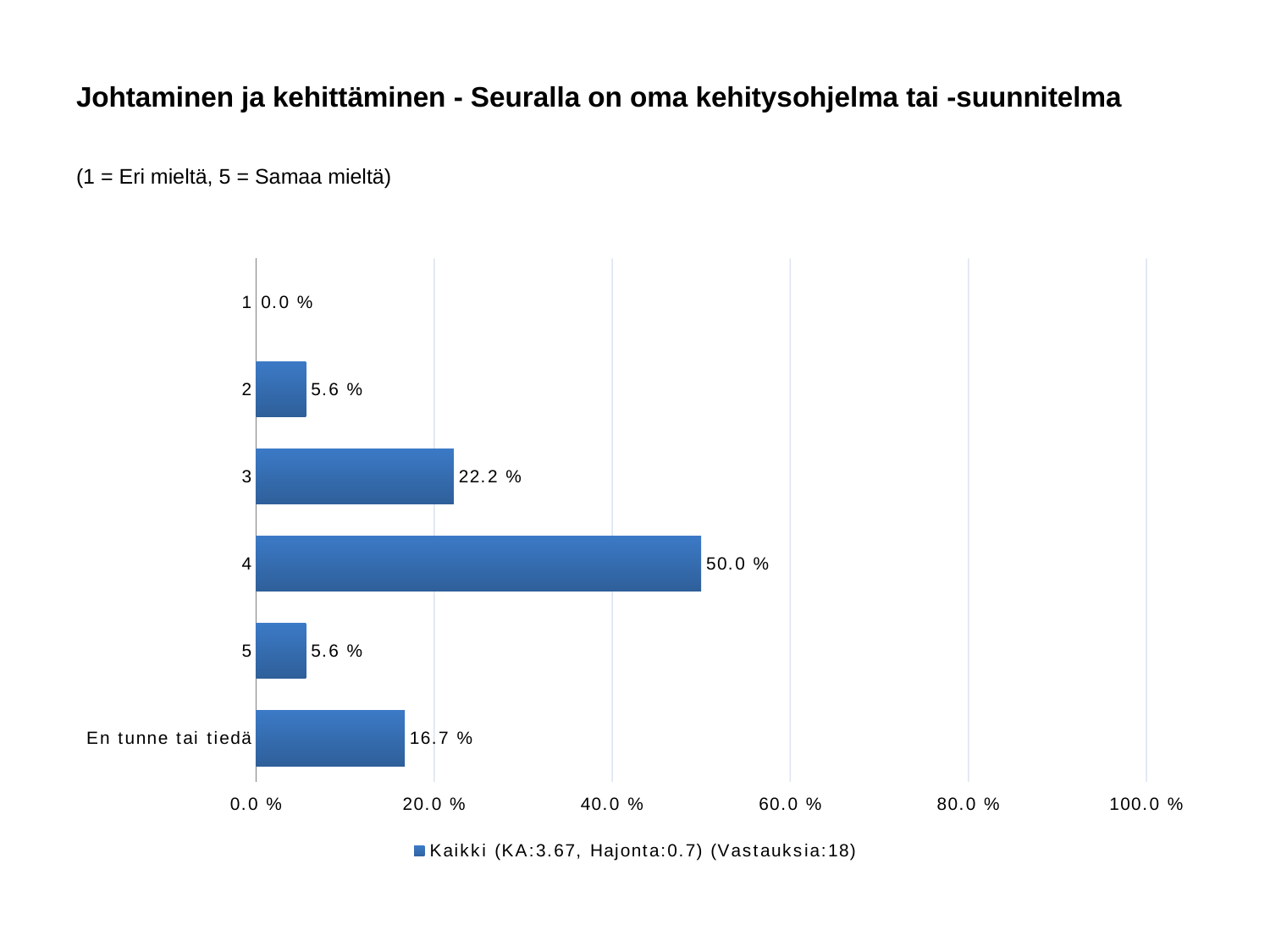
What is the value for category 1? 0.0 % What is the value for the category "En tunne tai tiedä"? 16.7 % What is the legend entry for the series shown? Kaikki (KA:3.67, Hajonta:0.7) (Vastauksia:18) Which category has the highest value? 4 Is the value for category 4 greater or less than 40.0 %? greater Which category has the lowest value? 1 What is the value for category 3? 22.2 % What kind of chart is shown on the slide? bar chart What is the value for category 4? 50.0 % Which is larger, the value for category 3 or the value for "En tunne tai tiedä"? 3 What is the difference between the values for category 4 and category 3? 27.8 % How many categories are shown on the chart? 6